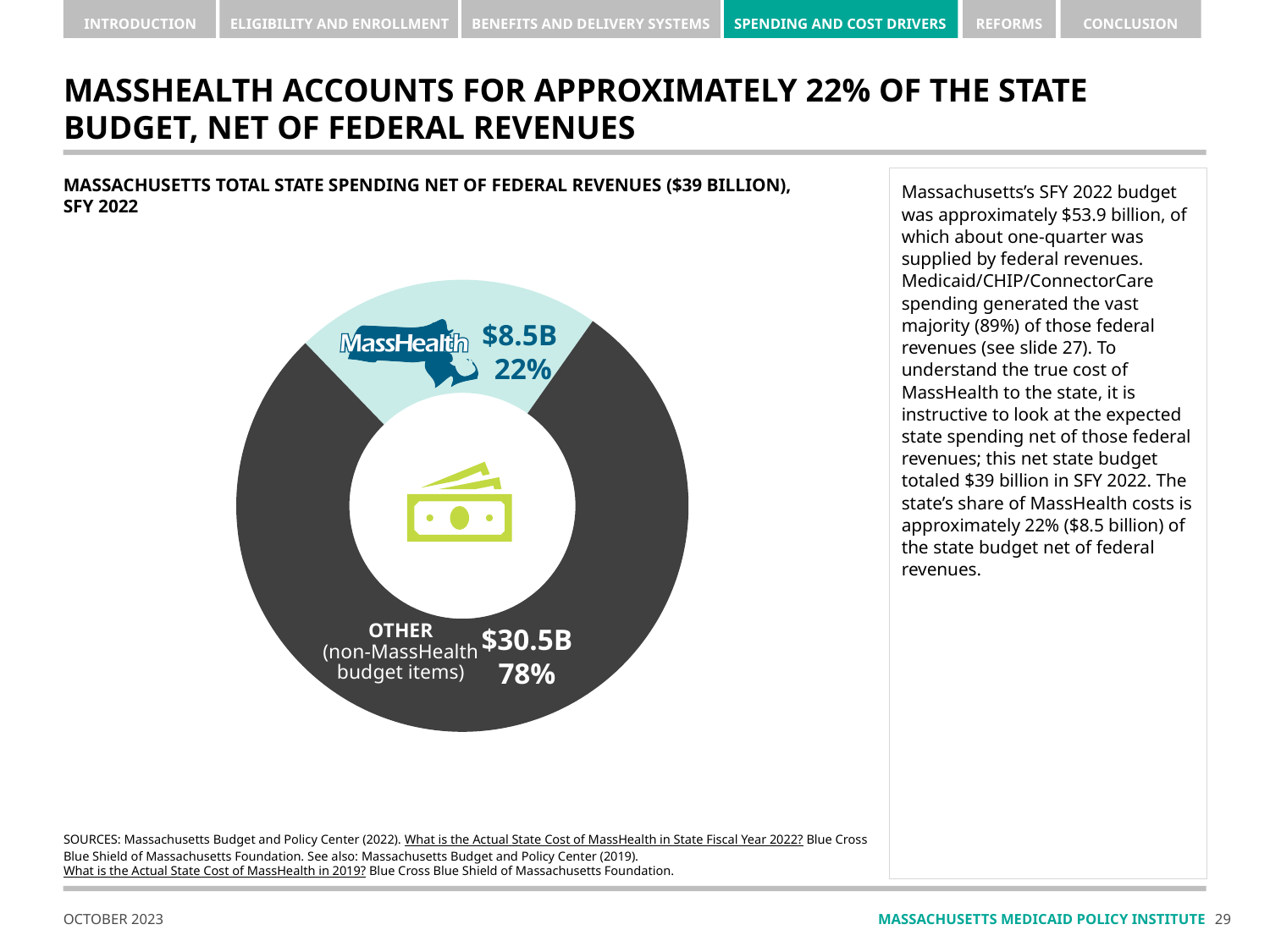
How many slices does the chart have? 2 What is the dollar value shown for MassHealth in the chart? $8.5B What fiscal year does the chart cover? SFY 2022 Which is larger, the MassHealth slice or the Other slice? Other What share of the pie does Other (non-MassHealth budget items) represent? 78% What kind of chart is shown on the slide? Pie chart (donut) What is the total state spending net of federal revenues stated in the chart title? $39 billion What is the difference in dollars between the Other slice and the MassHealth slice? $22B What is the dollar value shown for Other (non-MassHealth budget items)? $30.5B What share of the pie does MassHealth represent? 22% Which slice of the chart is the largest? Other (non-MassHealth budget items) Which slice of the chart is the smallest? MassHealth